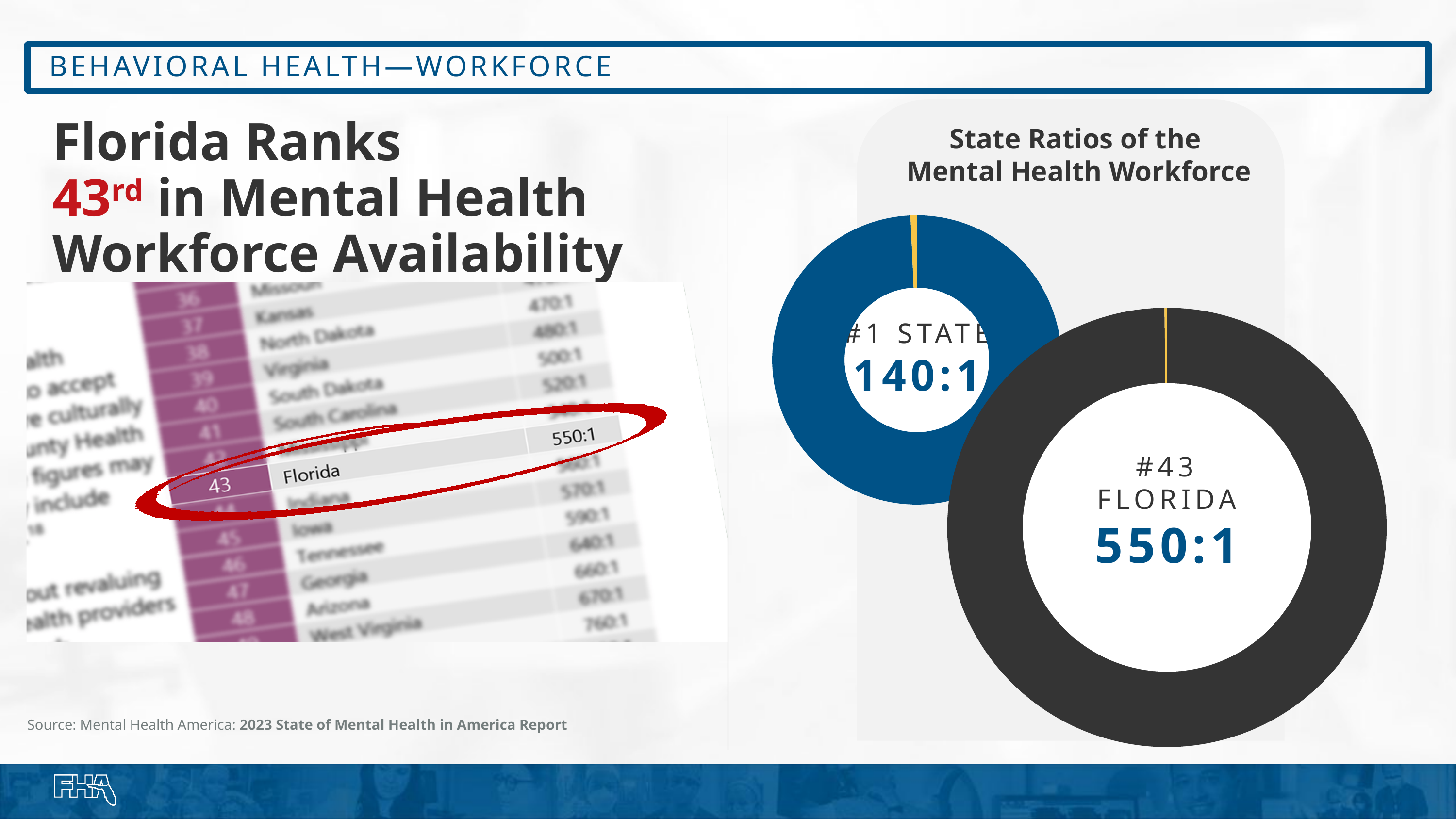
In the State Ratios of the Mental Health Workforce chart, what rank is shown for Florida? #43 In the State Ratios of the Mental Health Workforce chart, how many more people per provider does Florida's ratio show compared with the #1 state's ratio? 410 What is the title of the chart on the right side of the slide? State Ratios of the Mental Health Workforce In the State Ratios of the Mental Health Workforce chart, what is the ratio shown for the #1 state? 140:1 What kind of chart is used to show the State Ratios of the Mental Health Workforce? Donut chart In the State Ratios of the Mental Health Workforce chart, which has the larger ratio, Florida or the #1 state? Florida Is Florida's ratio in the State Ratios of the Mental Health Workforce chart greater or less than 500? greater In the State Ratios of the Mental Health Workforce chart, what is the ratio shown for Florida? 550:1 In the State Ratios of the Mental Health Workforce chart, what colour is the donut for Florida? Dark gray How many donut charts are shown under the State Ratios of the Mental Health Workforce heading? 2